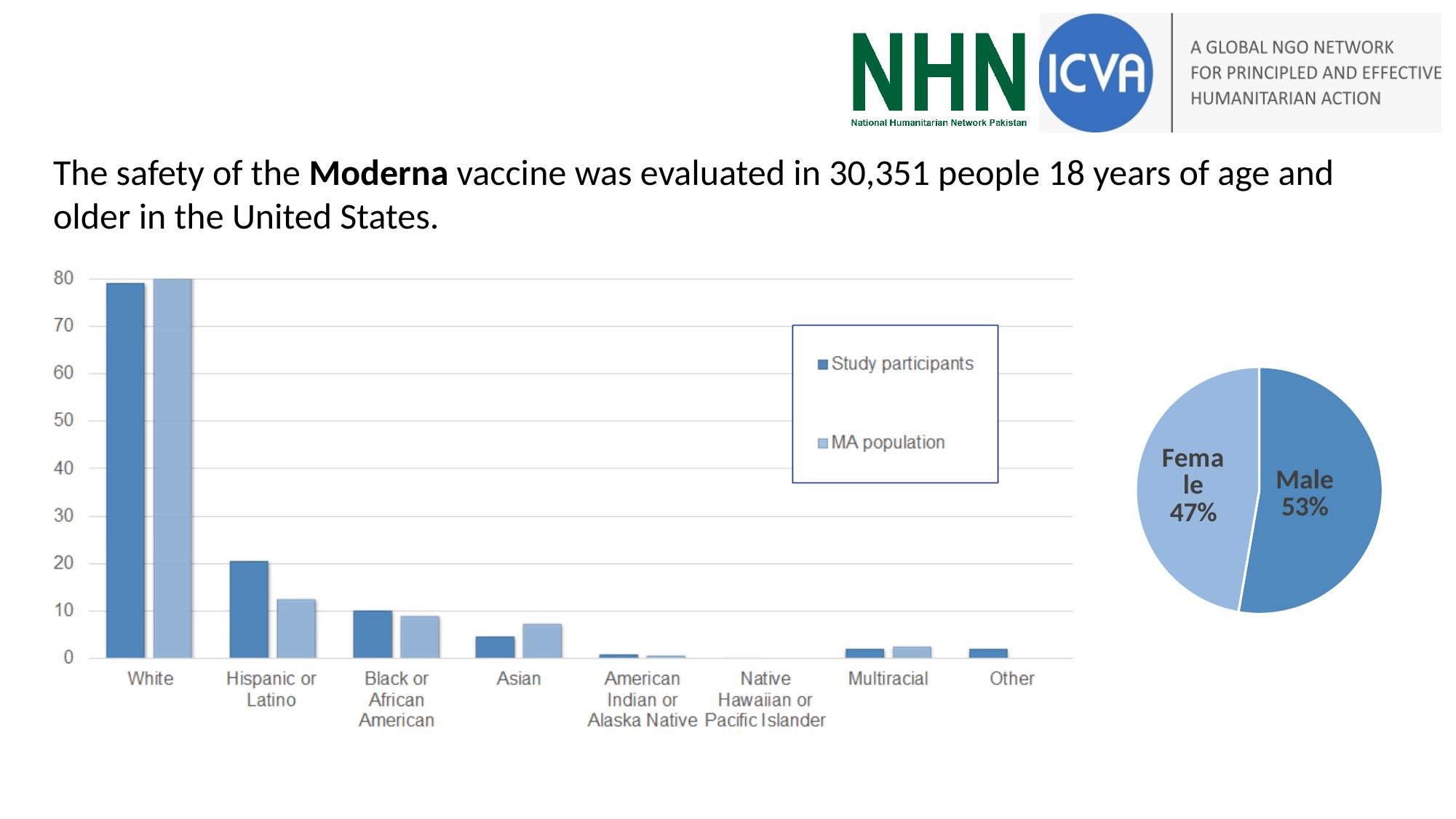
In the bar chart on the left, how many series does the legend list? 2 In the pie chart on the right, what share is Male? 53% In the bar chart on the left, which category has the lowest value for Study participants? Native Hawaiian or Pacific Islander What kind of chart is the chart on the right of the slide? pie chart In the bar chart on the left, how many categories are shown on the x axis? 8 In the bar chart on the left, is the MA population value for Asian greater or less than 10? less What kind of chart is the chart on the left of the slide? bar chart In the bar chart on the left, which category has the highest value for Study participants? White In the bar chart on the left, is the Study participants value for White greater or less than 70? greater In the bar chart on the left, for Asian, which series has the larger value: Study participants or MA population? MA population In the bar chart on the left, for Hispanic or Latino, which series has the larger value: Study participants or MA population? Study participants In the pie chart on the right, what is the difference between the Male and Female shares? 6%